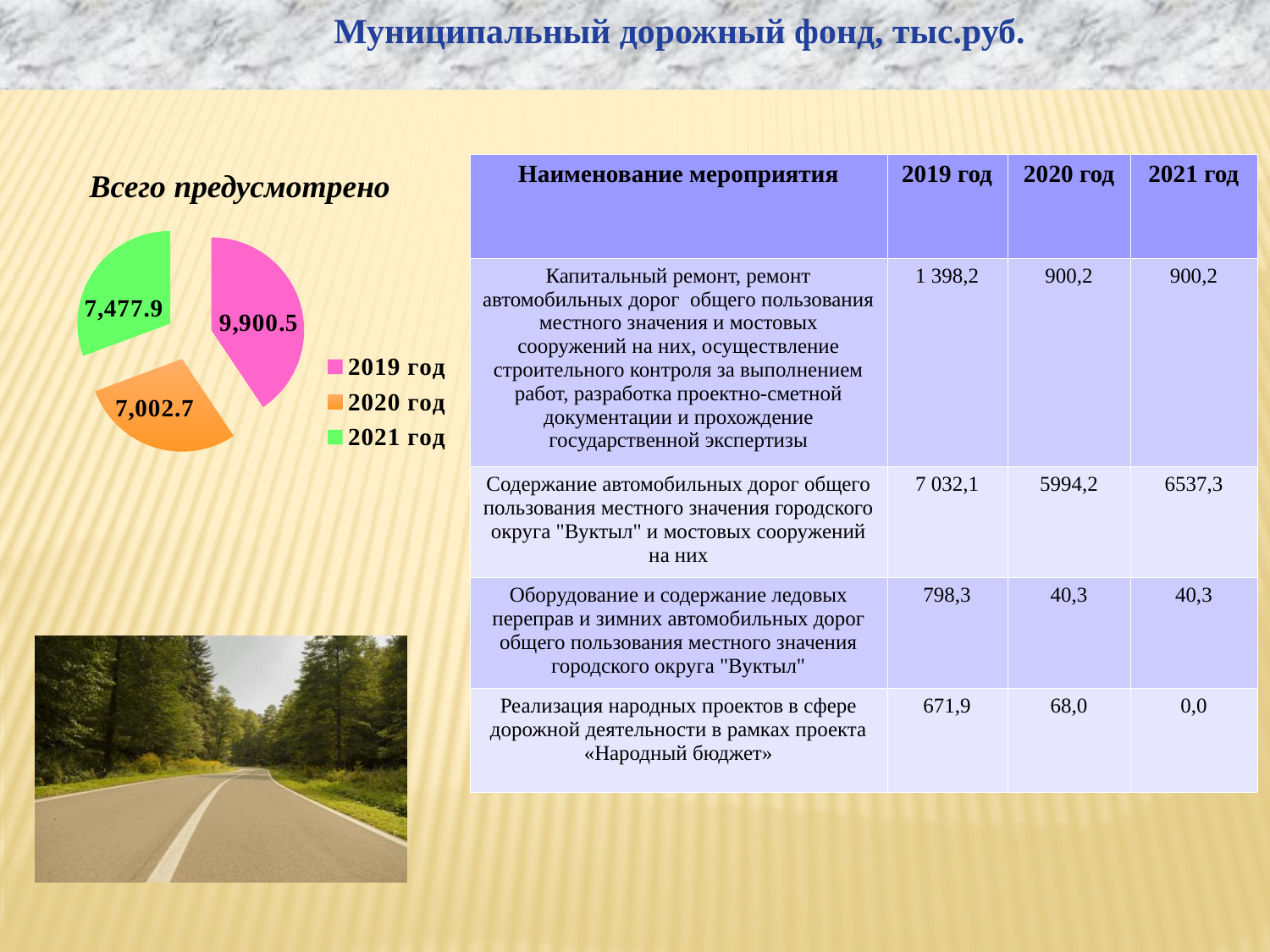
How many entries does the legend of the pie chart list? 3 In the pie chart, what is the difference between the values for 2019 год and 2020 год? 2,897.8 In the pie chart, which is larger: the value for 2021 год or the value for 2020 год? 2021 год Which year has the smallest slice in the pie chart? 2020 год How many slices does the pie chart have? 3 In the pie chart, what is the difference between the values for 2021 год and 2020 год? 475.2 In the pie chart, what is the value for 2019 год? 9,900.5 What kind of chart is shown under the heading "Всего предусмотрено"? Pie chart In the pie chart, what is the value for 2020 год? 7,002.7 In the pie chart, what is the value for 2021 год? 7,477.9 Which year has the largest slice in the pie chart? 2019 год What colour is the slice for 2021 год in the pie chart? Green